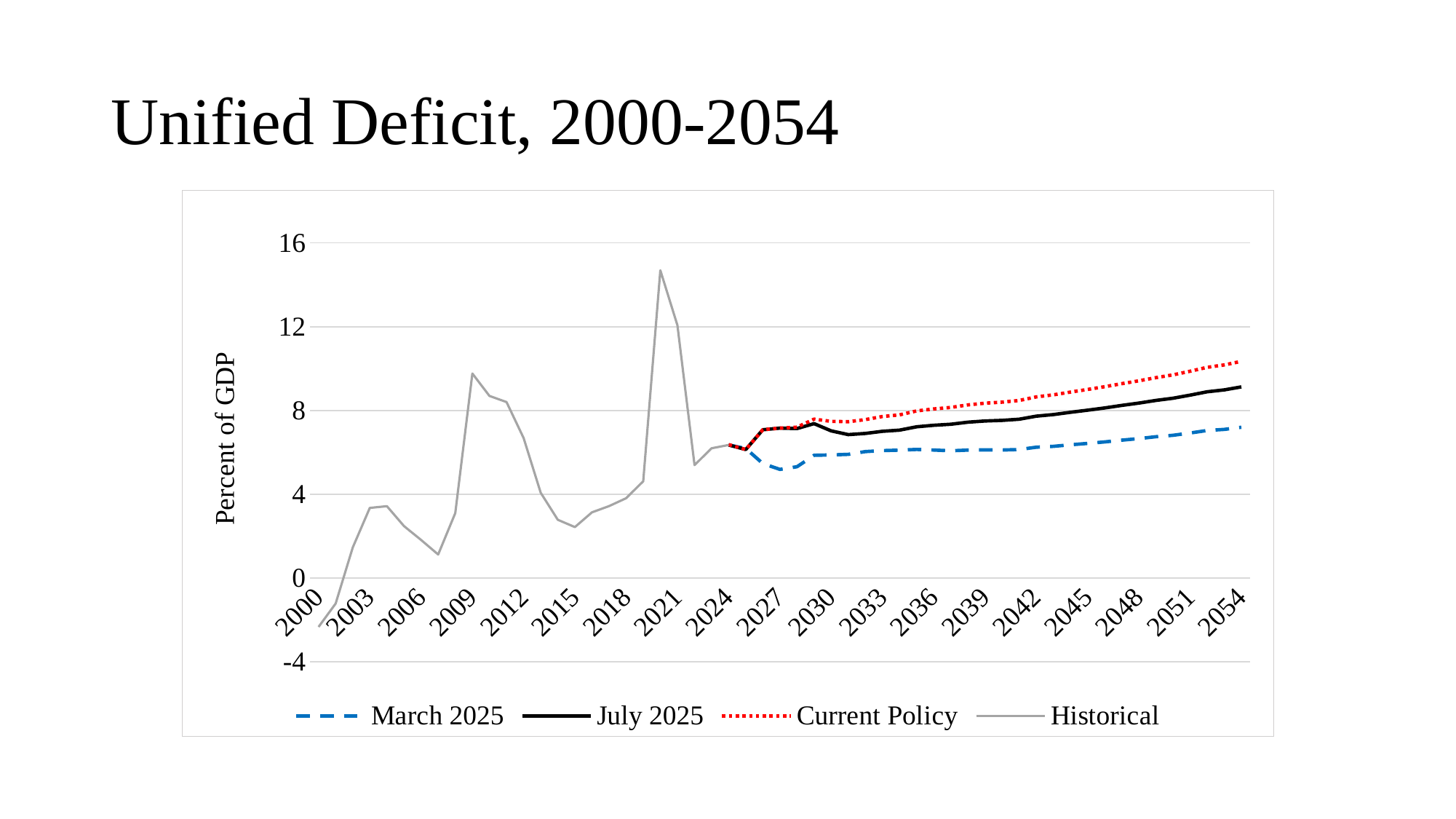
Is the peak value of the Historical series greater or less than 12? greater How many series does the legend list? 4 Which series has the highest value in 2054? Current Policy Is the Current Policy value in 2054 greater or less than 8? greater Which series has the lowest value in 2054? March 2025 Is the Historical value in 2000 greater or less than 0? less What is the title of the chart? Unified Deficit, 2000-2054 What is the label on the vertical axis? Percent of GDP What kind of chart is shown on the slide? line chart Does the July 2025 series rise or fall between 2033 and 2054? rise